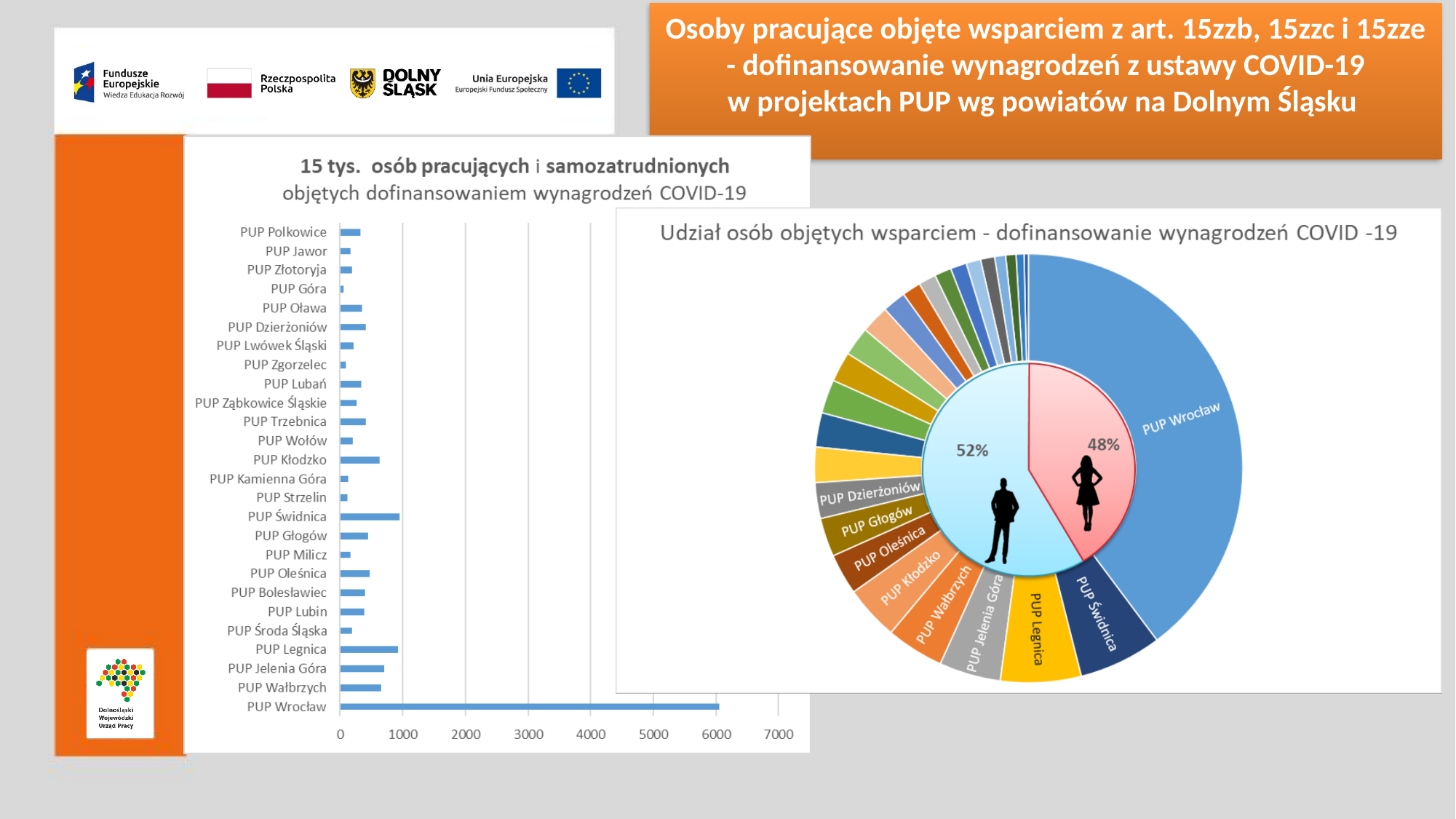
What kind of chart is the chart on the right, titled 'Udział osób objętych wsparciem - dofinansowanie wynagrodzeń COVID -19'? pie chart In the bar chart on the left, which has the larger value, PUP Kłodzko or PUP Polkowice? PUP Kłodzko In the pie chart on the right, what percentage is shown on the inner pie slice with the male figure? 52% In the pie chart on the right, what percentage is shown on the inner pie slice with the female figure? 48% How many PUP categories are shown in the bar chart on the left? 26 What kind of chart is the chart on the left of the slide, titled '15 tys. osób pracujących i samozatrudnionych objętych dofinansowaniem wynagrodzeń COVID-19'? bar chart In the pie chart on the right, which PUP has the largest slice? PUP Wrocław In the bar chart on the left, which has the larger value, PUP Legnica or PUP Jelenia Góra? PUP Legnica In the bar chart on the left, is the value for PUP Wrocław greater or less than 5000? greater In the bar chart on the left, which PUP has the lowest value? PUP Góra In the bar chart on the left, which PUP has the highest value? PUP Wrocław